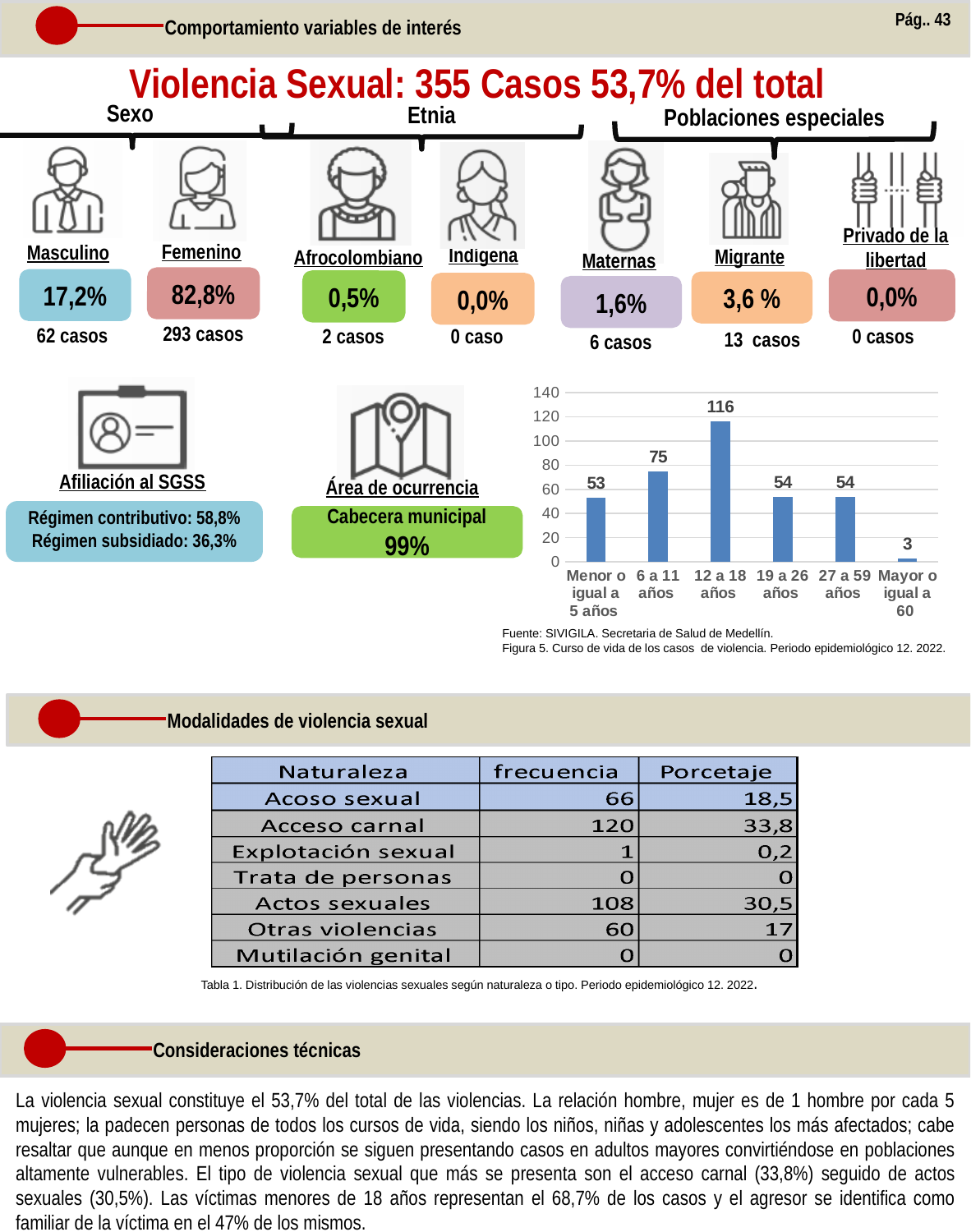
What is the value for the 12 a 18 años age group in the bar chart? 116 Which is larger in the bar chart, the value for 6 a 11 años or the value for 27 a 59 años? 6 a 11 años What kind of chart is used to show the cases by age group? Bar chart Is the value for 12 a 18 años in the bar chart greater or less than 100? greater What is the value for the 6 a 11 años age group in the bar chart? 75 What is the value for the Mayor o igual a 60 age group in the bar chart? 3 Which age group has the highest value in the bar chart? 12 a 18 años What is the value for the Menor o igual a 5 años age group in the bar chart? 53 What is the difference between the values for 12 a 18 años and 6 a 11 años in the bar chart? 41 What is the difference between the values for 19 a 26 años and Mayor o igual a 60 in the bar chart? 51 How many age groups are shown in the bar chart? 6 Which age group has the lowest value in the bar chart? Mayor o igual a 60